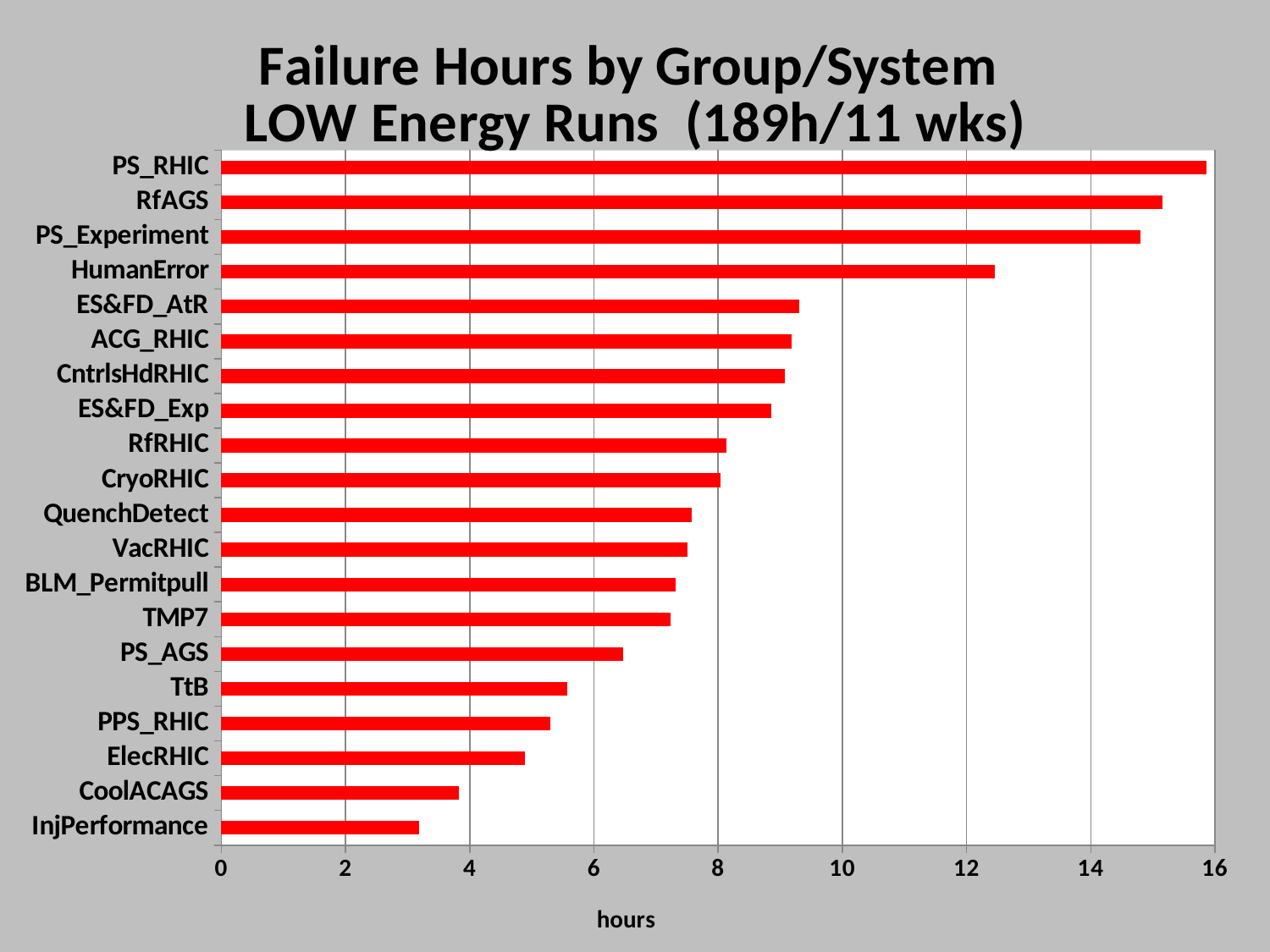
Is the value for ES&FD_AtR greater or less than 10? less Is the value for HumanError greater or less than 12? greater How many groups/systems are listed on the chart? 20 Is the value for InjPerformance greater or less than 4? less Which has more failure hours, PS_AGS or TtB? PS_AGS Which has more failure hours, HumanError or ES&FD_AtR? HumanError What kind of chart is shown on the slide? bar chart Which group/system has the lowest failure hours? InjPerformance Which group/system has the highest failure hours? PS_RHIC What is the label on the horizontal axis of the chart? hours